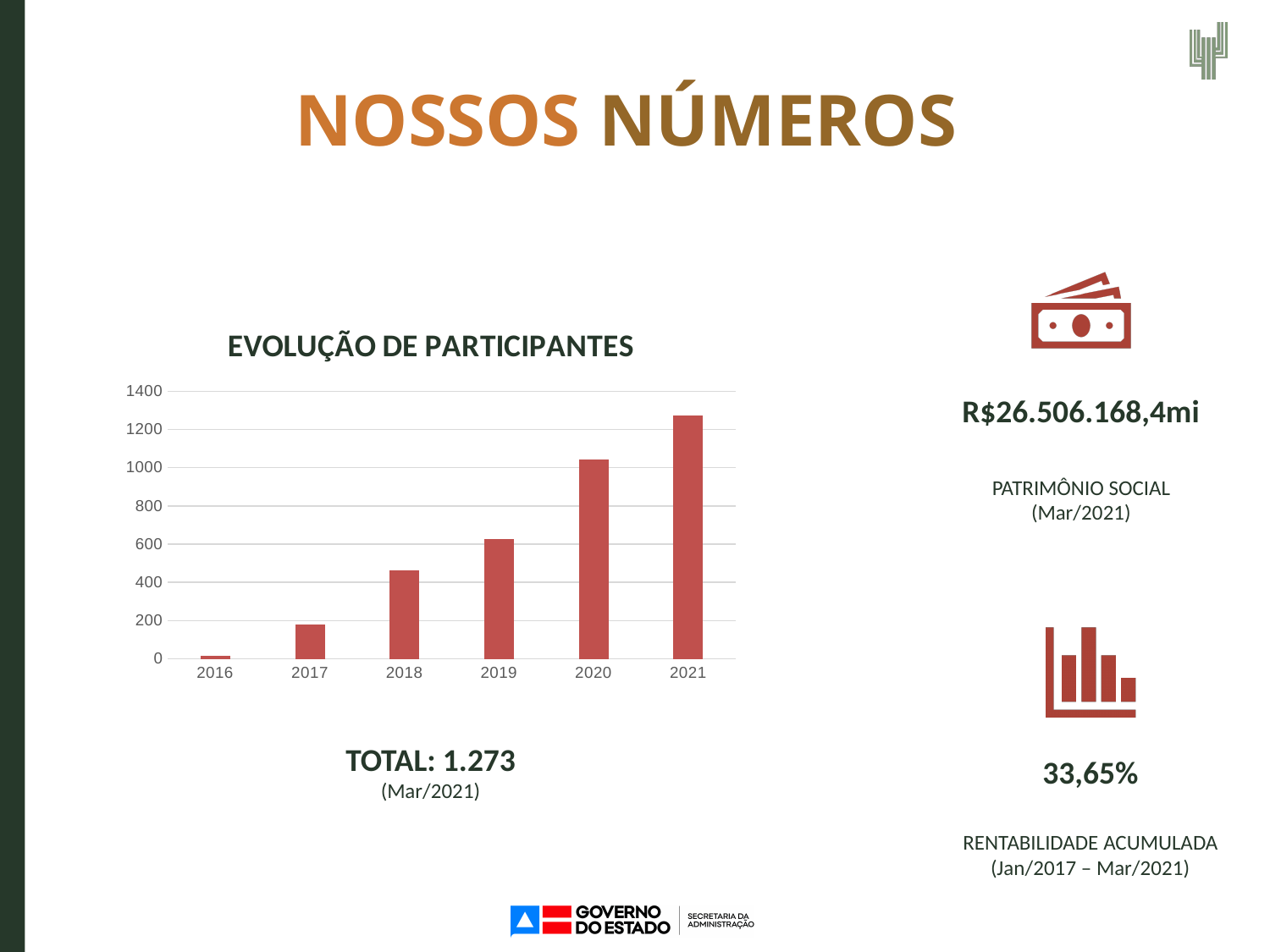
Is the value for 2020 in the EVOLUÇÃO DE PARTICIPANTES chart greater or less than 1000? greater Is the value for 2021 in the EVOLUÇÃO DE PARTICIPANTES chart greater or less than 1200? greater Do the values in the EVOLUÇÃO DE PARTICIPANTES chart rise or fall from 2016 to 2021? rise In the EVOLUÇÃO DE PARTICIPANTES chart, which is larger, the value for 2019 or the value for 2020? 2020 What kind of chart is shown under the title EVOLUÇÃO DE PARTICIPANTES? bar chart How many years are shown on the x axis of the EVOLUÇÃO DE PARTICIPANTES chart? 6 Which year has the highest bar in the EVOLUÇÃO DE PARTICIPANTES chart? 2021 Is the value for 2018 in the EVOLUÇÃO DE PARTICIPANTES chart greater or less than 400? greater Which year has the lowest bar in the EVOLUÇÃO DE PARTICIPANTES chart? 2016 What is the highest value shown on the y axis of the EVOLUÇÃO DE PARTICIPANTES chart? 1400